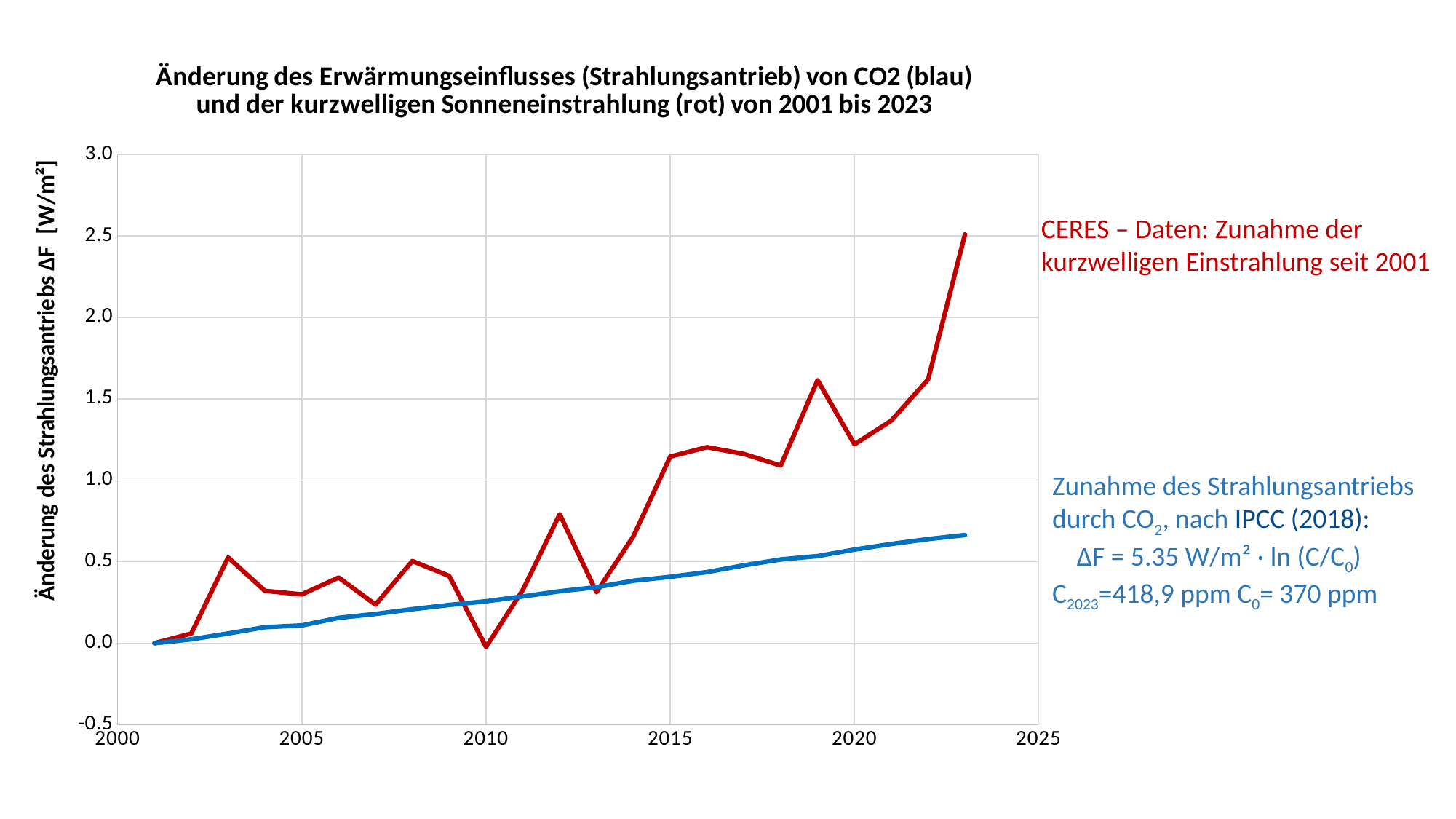
In 2023, which line has the higher value, the red line or the blue line? red line Does the blue line rise or fall from 2001 to 2023? rise How many lines are plotted on the chart? 2 Is the value of the red line in 2019 greater or less than 1.0? greater In which year does the red line reach its highest value? 2023 Is the value of the red line in 2023 greater or less than 2.0? greater In 2010, which line has the higher value, the red line or the blue line? blue line What kind of chart is shown on the slide? line chart Is the value of the red line in 2010 greater or less than 0.5? less What is the label of the y axis? Änderung des Strahlungsantriebs ΔF [W/m²] Which colour is used for the CO2 radiative forcing line? blue